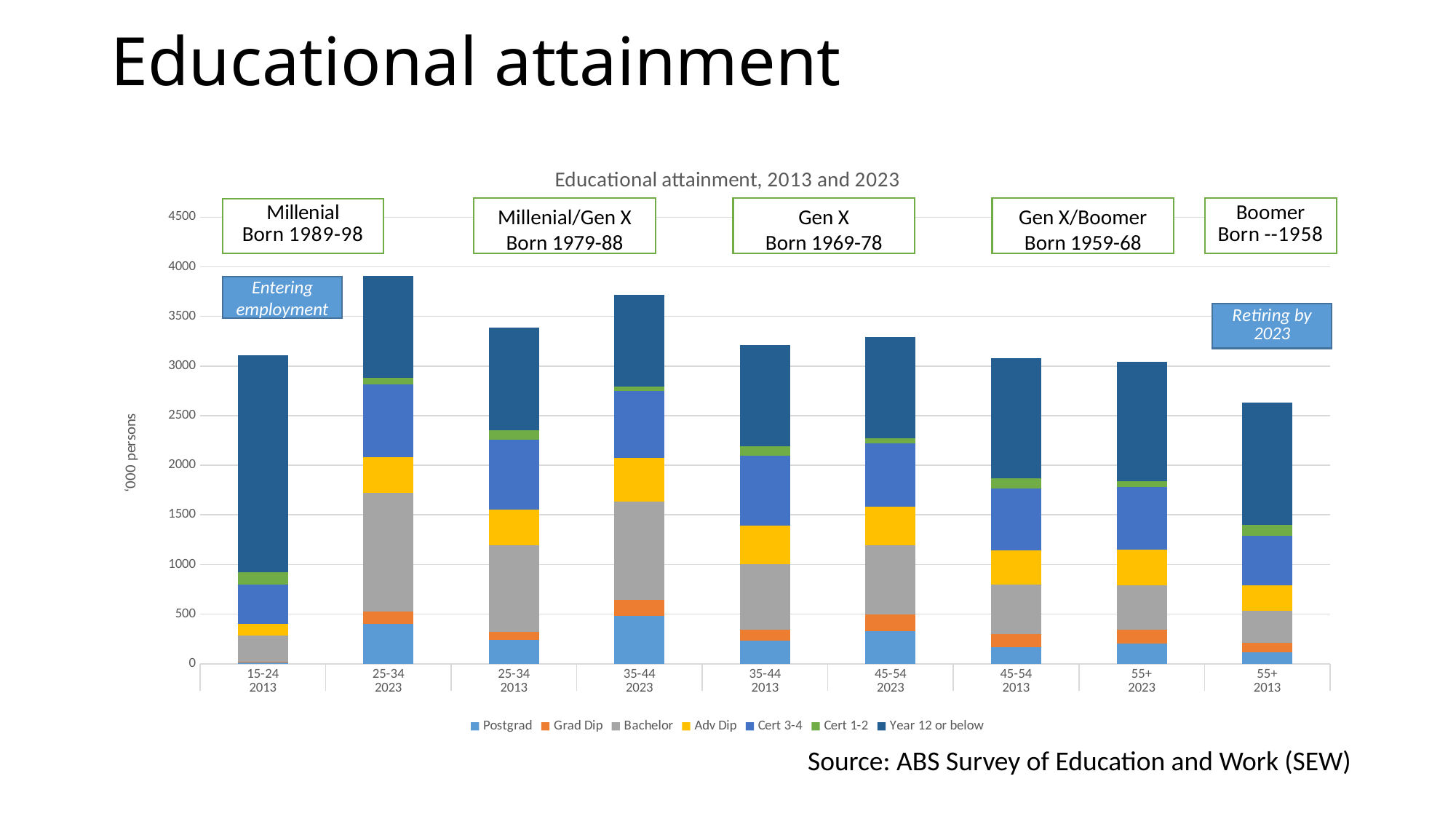
Is the total for 45-54 2023 greater or less than 3000? greater Which bar has the highest total in the chart? 25-34 2023 What is the title of the chart? Educational attainment, 2013 and 2023 Which bar has the lowest total in the chart? 55+ 2013 Is the total for 55+ 2013 greater or less than 3000? less Which bar has the larger total, 55+ 2013 or 55+ 2023? 55+ 2023 How many bars (age group and year categories) are plotted in the chart? 9 Is the total for 25-34 2023 greater or less than 3500? greater What kind of chart is shown on the slide? Stacked bar chart How many series does the chart's legend list? 7 Which bar has the larger total, 25-34 2013 or 25-34 2023? 25-34 2023